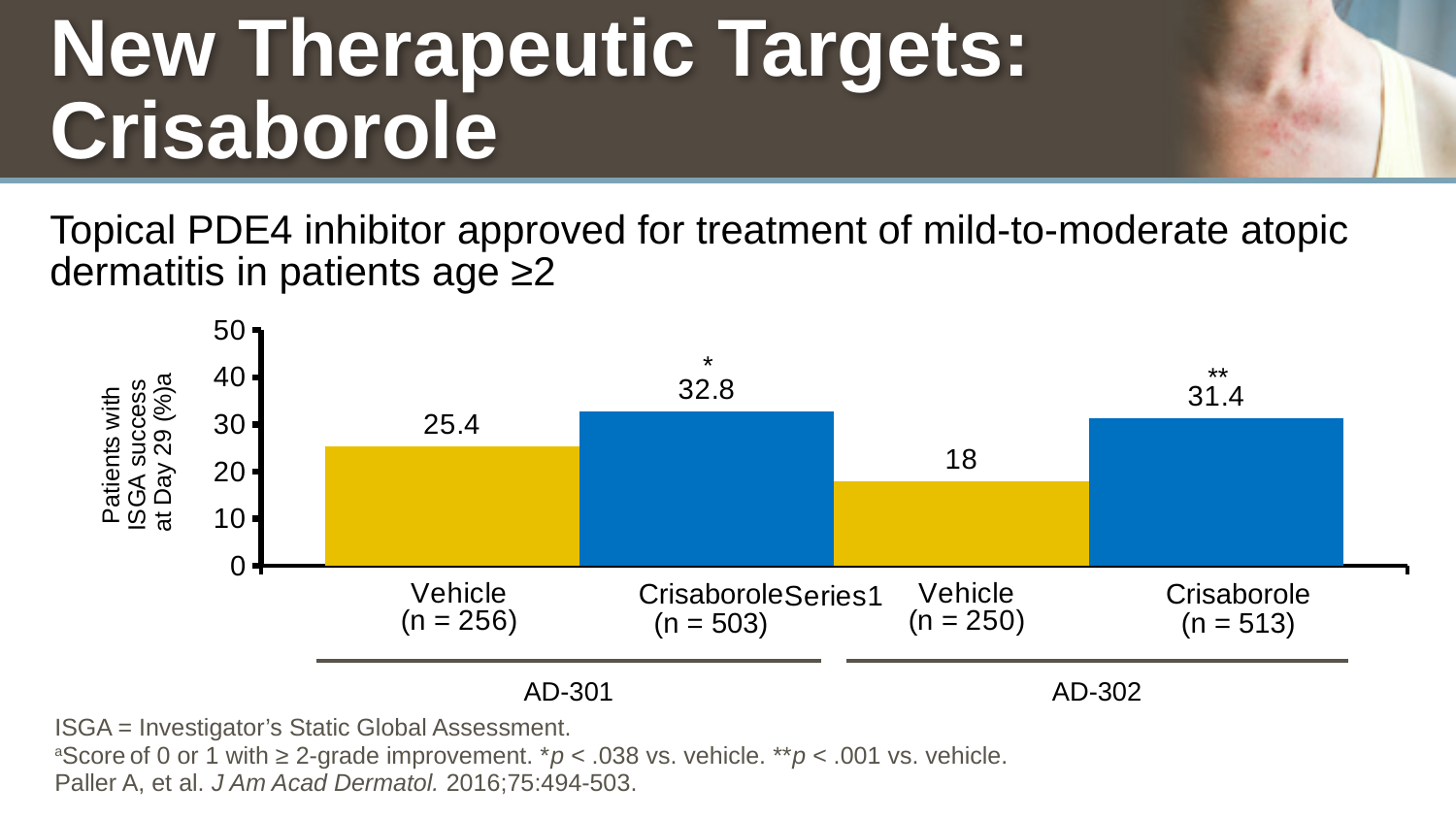
What is the value for Crisaborole (n = 513) in the AD-302 study? 31.4 Which bar has the highest value? Crisaborole (n = 503) What type of chart is shown on the slide? Bar chart Which bar has the lowest value? Vehicle (n = 250) What is the value for Vehicle (n = 256) in the AD-301 study? 25.4 Which is larger, the Vehicle value in AD-301 or the Vehicle value in AD-302? Vehicle in AD-301 What is the value for Vehicle (n = 250) in the AD-302 study? 18 What is the difference between the Crisaborole and Vehicle values in the AD-301 study? 7.4 What is the difference between the Crisaborole and Vehicle values in the AD-302 study? 13.4 How many bars are plotted in the chart? 4 What is the value for Crisaborole (n = 503) in the AD-301 study? 32.8 What is the label of the vertical axis? Patients with ISGA success at Day 29 (%)